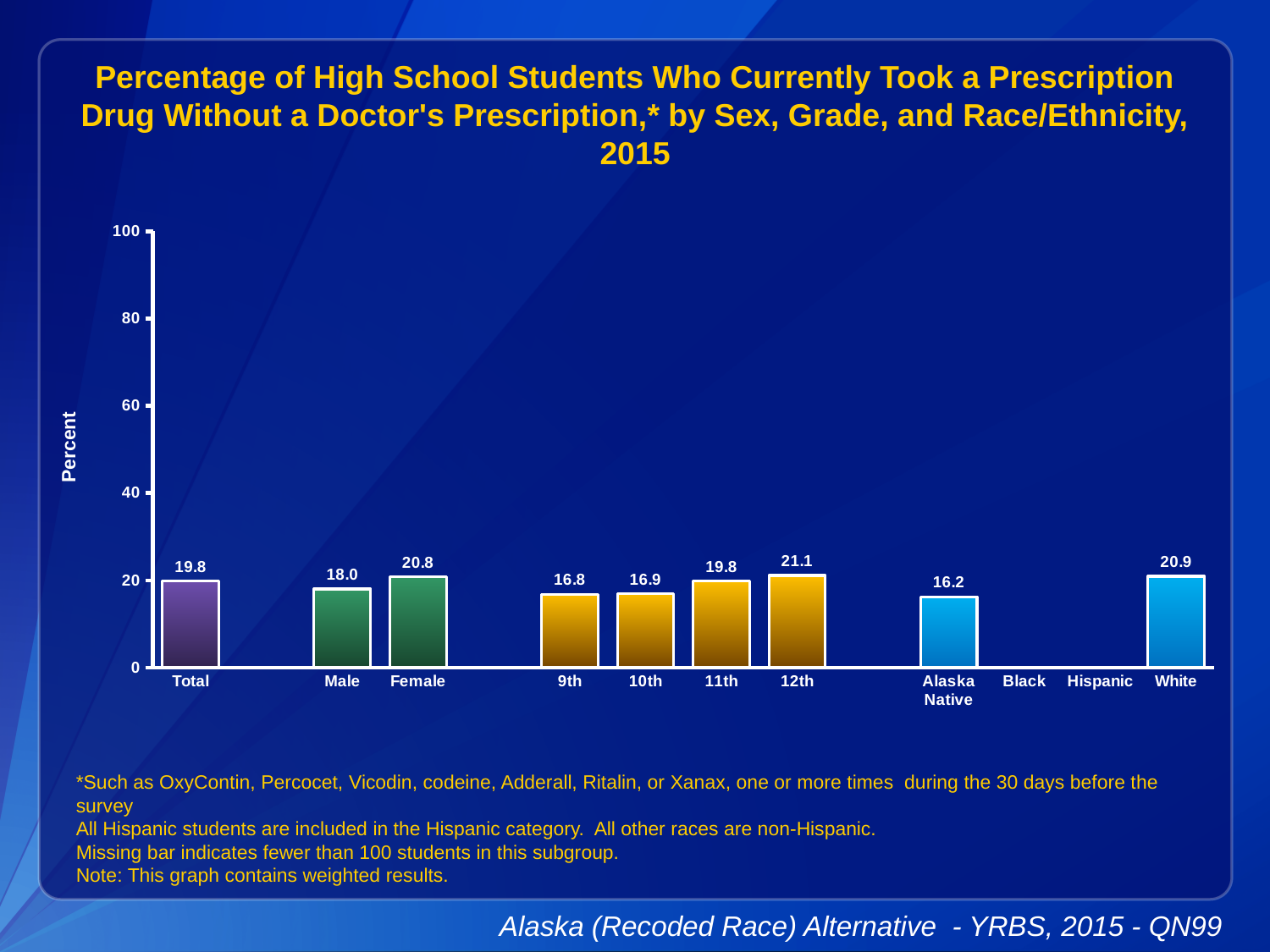
Which grade has the highest value? 12th What is the value for Alaska Native? 16.2 What is the label on the y axis? Percent Which is larger, the value for White or the value for Total? White How many categories on the x axis have no bar shown? 2 What is the value for Female? 20.8 What is the difference between the Female and Male values? 2.8 What is the value for 12th grade? 21.1 Is the value for 9th grade greater or less than 20? less What kind of chart is shown on the slide? bar chart Which category has the lowest value among those with a bar shown? Alaska Native Do the values rise or fall from 9th grade to 12th grade? rise